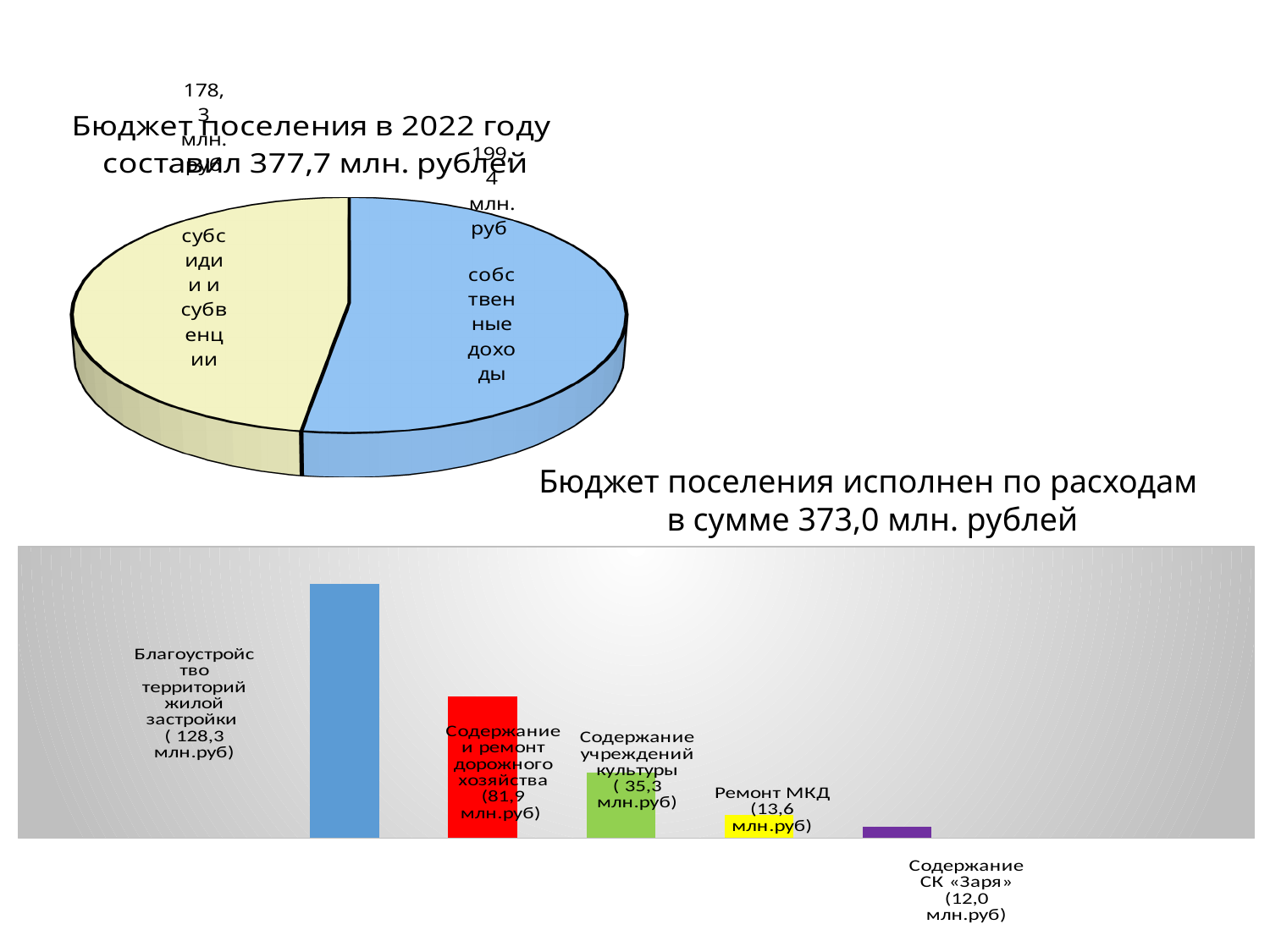
In the bar chart at the bottom of the slide, how many bars are there? 5 In the bar chart at the bottom of the slide, what is the value for Благоустройство территорий жилой застройки? 128,3 млн.руб In the pie chart at the top of the slide, how many slices are there? 2 In the bar chart at the bottom of the slide, which category has the lowest value? Содержание СК «Заря» In the bar chart at the bottom of the slide, which category has the highest value? Благоустройство территорий жилой застройки In the bar chart at the bottom of the slide, what is the value for Содержание и ремонт дорожного хозяйства? 81,9 млн.руб In the bar chart at the bottom of the slide, what is the value for Ремонт МКД? 13,6 млн.руб What kind of chart is shown at the top of the slide? pie chart In the bar chart at the bottom of the slide, what is the difference between Благоустройство территорий жилой застройки and Содержание и ремонт дорожного хозяйства? 46,4 млн.руб In the pie chart at the top of the slide, what is the value for собственные доходы? 199,4 млн. руб In the pie chart at the top of the slide, what is the value for субсидии и субвенции? 178,3 млн. руб In the pie chart at the top of the slide, which slice is larger: собственные доходы or субсидии и субвенции? собственные доходы